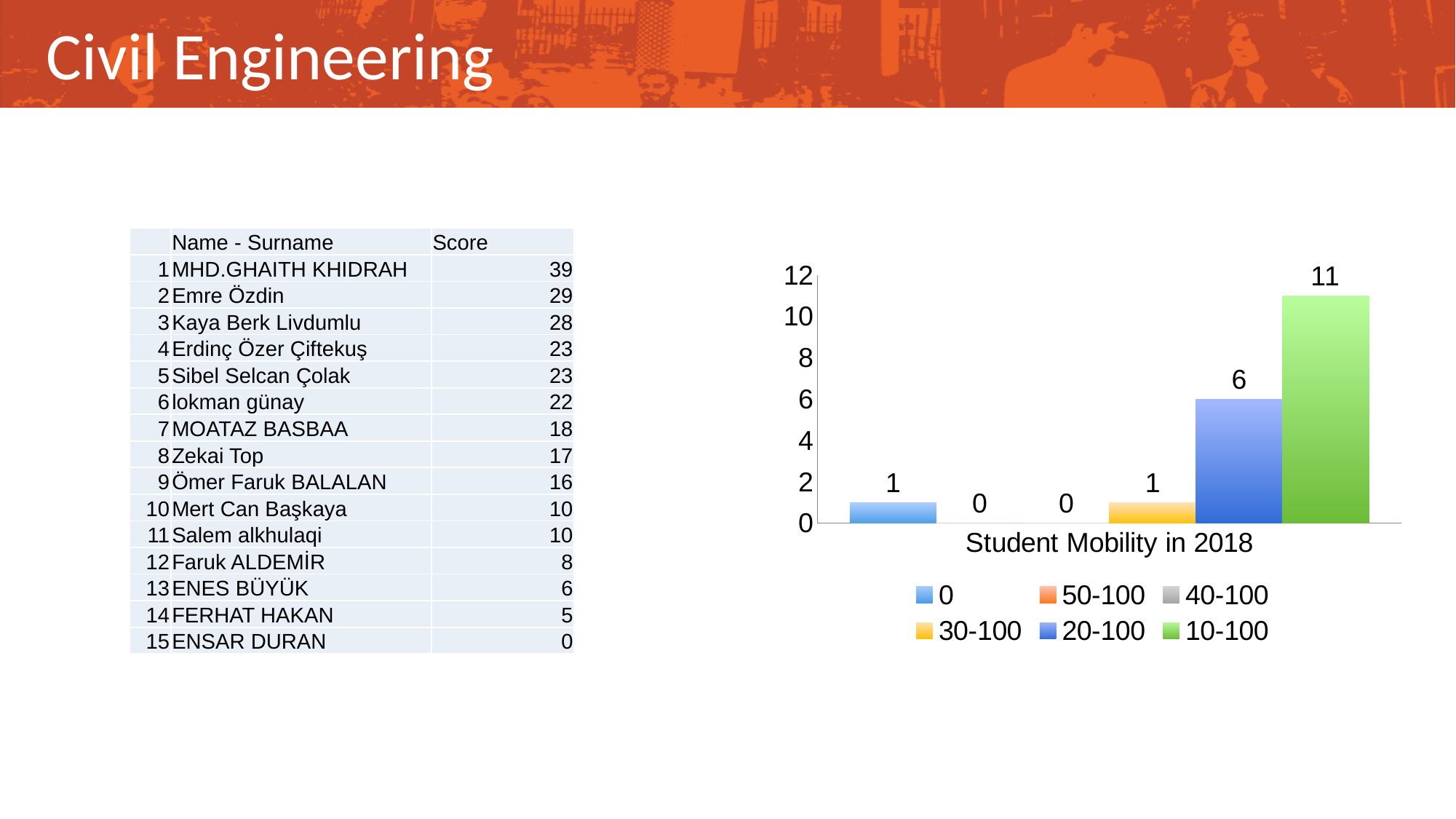
What kind of chart is the Student Mobility in 2018 chart? bar chart What colour is the bar for the 10-100 series in the Student Mobility in 2018 chart? green How many series does the legend of the Student Mobility in 2018 chart list? 6 What is the value for the 20-100 series in the Student Mobility in 2018 chart? 6 What is the difference between the 10-100 and 20-100 values in the Student Mobility in 2018 chart? 5 Is the value for 10-100 in the Student Mobility in 2018 chart greater or less than 10? greater What is the value for the 10-100 series in the Student Mobility in 2018 chart? 11 What is the value for the 30-100 series in the Student Mobility in 2018 chart? 1 What is the total of all the values shown in the Student Mobility in 2018 chart? 19 Which series has the highest value in the Student Mobility in 2018 chart? 10-100 What is the value for the 50-100 series in the Student Mobility in 2018 chart? 0 Which is larger in the Student Mobility in 2018 chart, the value for 20-100 or the value for 30-100? 20-100